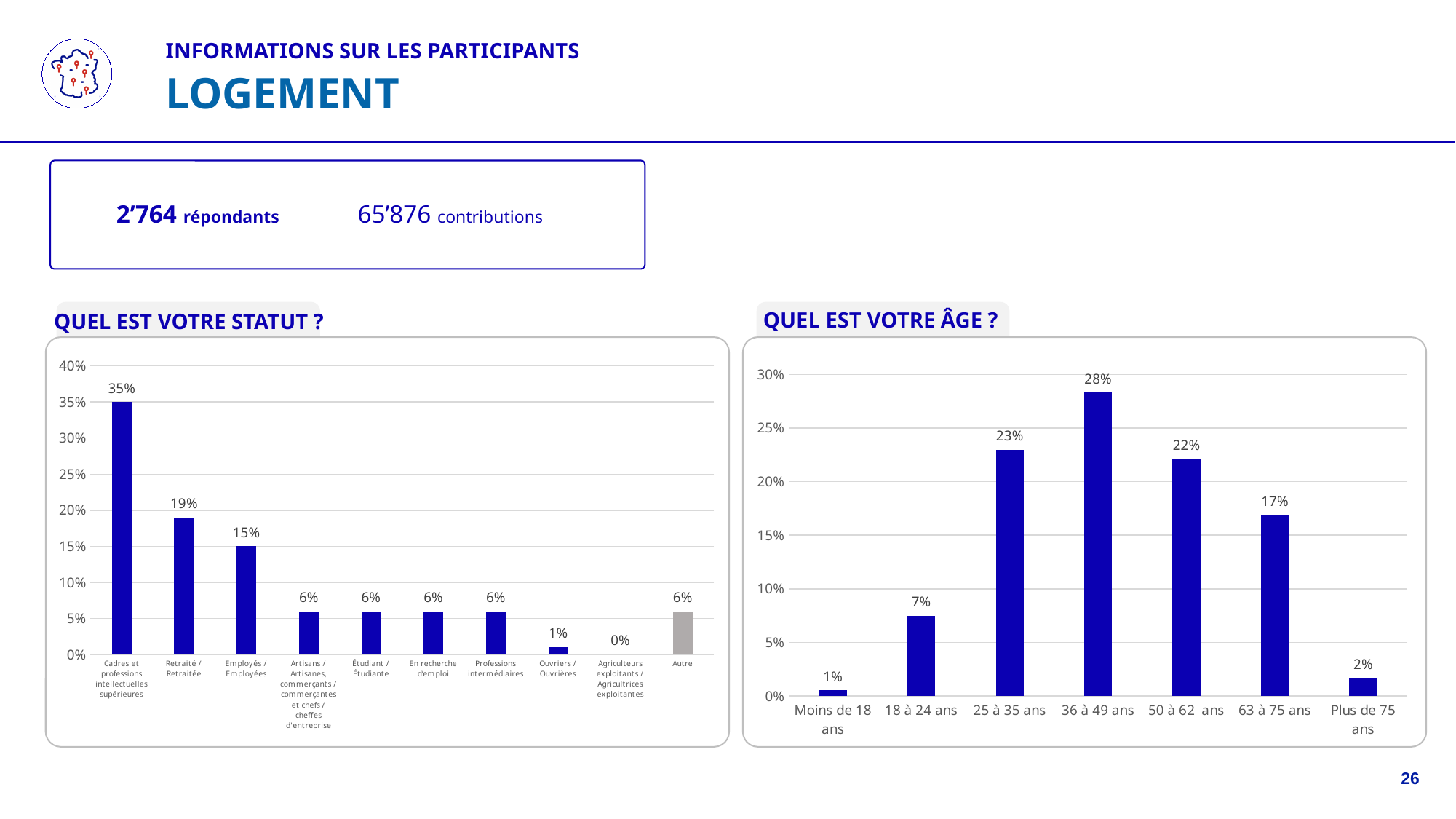
What kind of chart is 'QUEL EST VOTRE ÂGE ?'? Bar chart In the 'QUEL EST VOTRE ÂGE ?' chart, which age group has the highest value? 36 à 49 ans In the 'QUEL EST VOTRE STATUT ?' chart, what is the difference between Cadres et professions intellectuelles supérieures and Employés / Employées? 20% In the 'QUEL EST VOTRE STATUT ?' chart, which category has the highest value? Cadres et professions intellectuelles supérieures In the 'QUEL EST VOTRE ÂGE ?' chart, which is larger: 25 à 35 ans or 63 à 75 ans? 25 à 35 ans In the 'QUEL EST VOTRE ÂGE ?' chart, which age group has the lowest value? Moins de 18 ans In the 'QUEL EST VOTRE ÂGE ?' chart, what is the difference between 36 à 49 ans and 18 à 24 ans? 21% In the 'QUEL EST VOTRE STATUT ?' chart, which bar is coloured grey instead of blue? Autre In the 'QUEL EST VOTRE STATUT ?' chart, which category has the lowest value? Agriculteurs exploitants / Agricultrices exploitantes In the 'QUEL EST VOTRE STATUT ?' chart, how many categories are shown? 10 In the 'QUEL EST VOTRE ÂGE ?' chart, what is the value for 50 à 62 ans? 22% In the 'QUEL EST VOTRE STATUT ?' chart, what is the value for Retraité / Retraitée? 19%